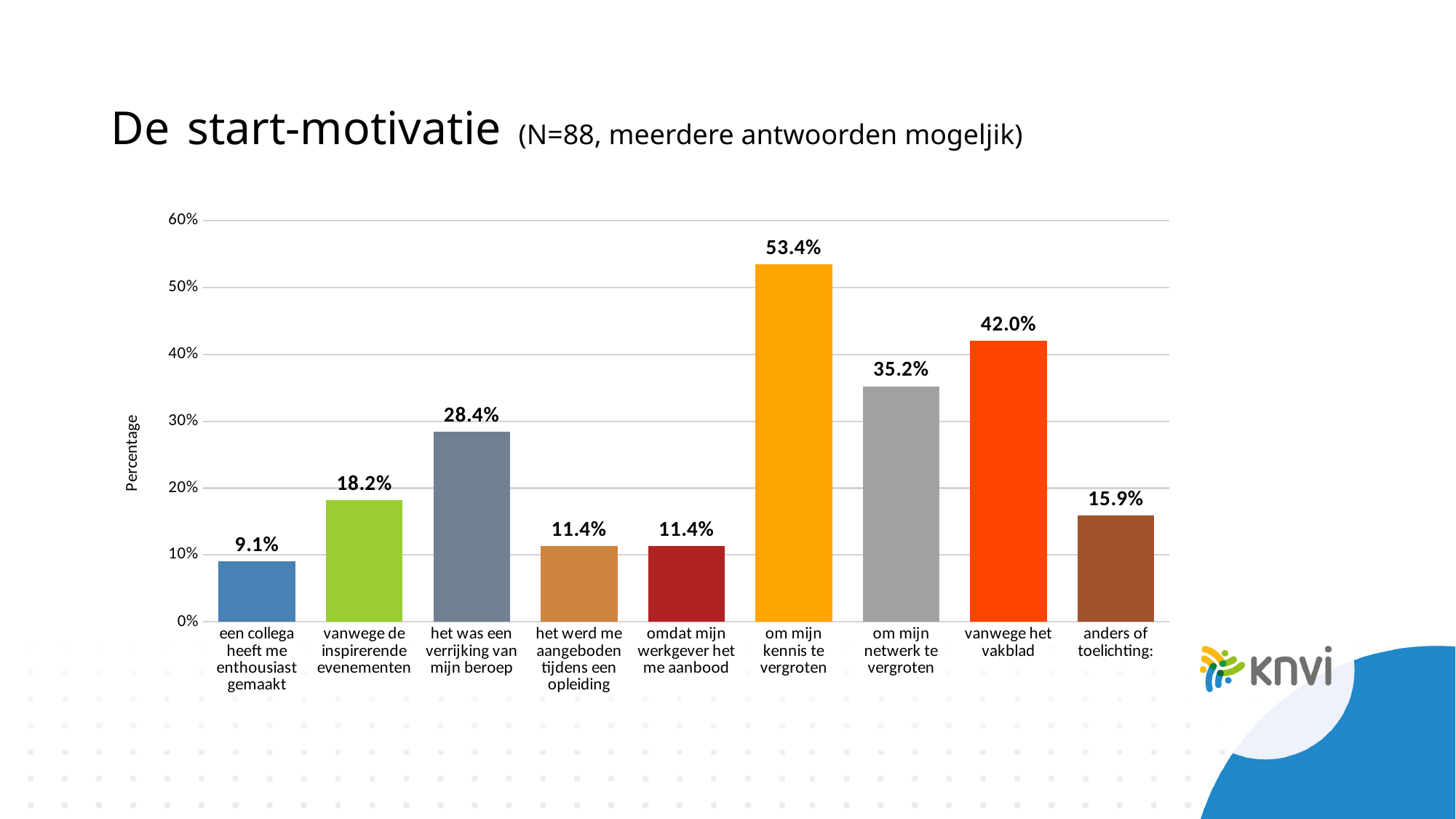
Which is larger: 'vanwege de inspirerende evenementen' or 'anders of toelichting:'? vanwege de inspirerende evenementen Which category has the highest percentage? om mijn kennis te vergroten What is the label of the vertical axis? Percentage Which category has the lowest percentage? een collega heeft me enthousiast gemaakt What is the difference between 'om mijn kennis te vergroten' and 'om mijn netwerk te vergroten'? 18.2% Is the value for 'het was een verrijking van mijn beroep' greater or less than 30%? less What is the value for 'vanwege het vakblad'? 42.0% What is the sample size (N) stated in the slide title? 88 What percentage is shown for 'om mijn kennis te vergroten'? 53.4% What kind of chart is shown on the slide? bar chart What percentage is shown for 'een collega heeft me enthousiast gemaakt'? 9.1% How many categories are shown on the x axis? 9